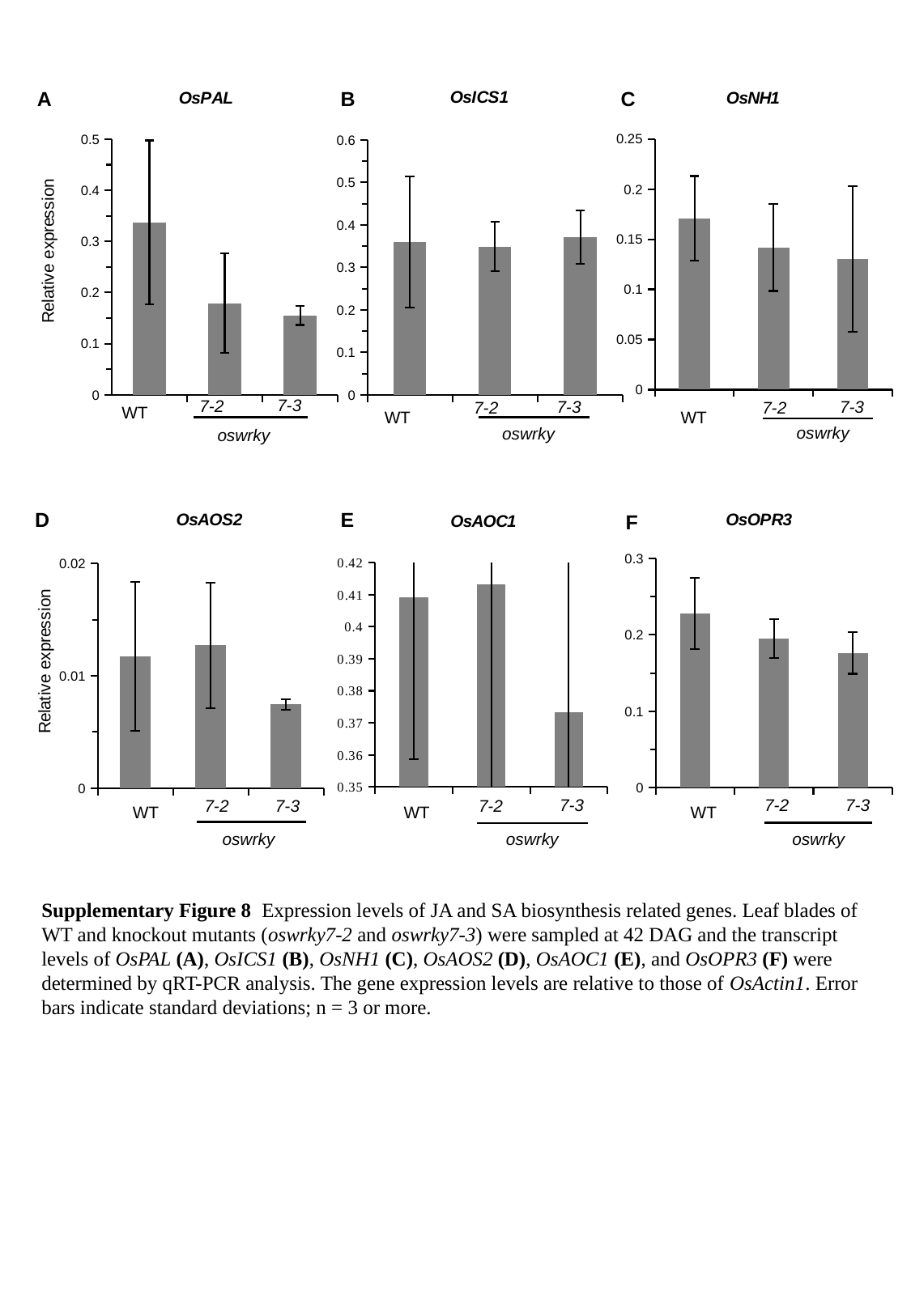
In the OsNH1 chart (C), which category has the highest relative expression? WT In the OsOPR3 chart (F), is the value for WT greater or less than 0.2? greater How many bars are plotted in the OsOPR3 chart (F)? 3 In the OsAOS2 chart (D), which category has the lowest relative expression? 7-3 In the OsPAL chart (A), is the value for WT greater or less than 0.3? greater In the OsAOS2 chart (D), is the value for 7-3 greater or less than 0.01? less In the OsPAL chart (A), which category has the highest relative expression? WT In the OsPAL chart (A), do the values rise or fall from WT to 7-3 along the x axis? fall In the OsAOC1 chart (E), which is larger, the value for WT or the value for 7-3? WT What kind of chart is the OsAOS2 chart (D)? bar chart